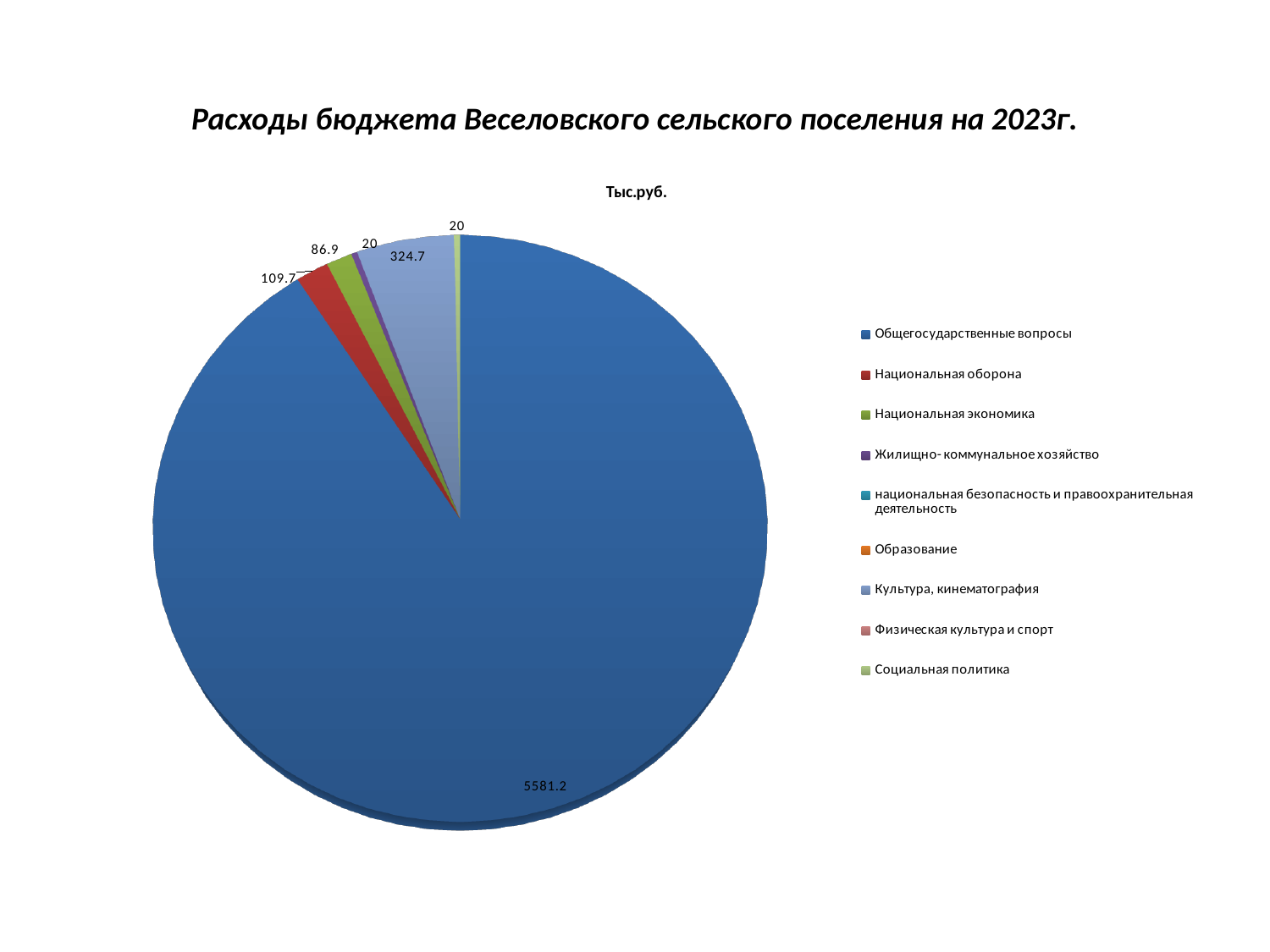
What kind of chart is shown on the slide? pie chart What is the difference between the values for Национальная оборона and Национальная экономика? 22.8 What is the value for Национальная экономика in the pie chart? 86.9 How many entries does the legend of the pie chart list? 9 Which category has the largest slice in the pie chart? Общегосударственные вопросы What is the title printed above the pie chart? Тыс.руб. Which is larger in the pie chart: Культура, кинематография or Национальная оборона? Культура, кинематография What is the value for Культура, кинематография in the pie chart? 324.7 What is the difference between the values for Культура, кинематография and Национальная оборона? 215 What is the value for Общегосударственные вопросы in the pie chart? 5581.2 What is the value for Национальная оборона in the pie chart? 109.7 Which is larger in the pie chart: Национальная оборона or Национальная экономика? Национальная оборона